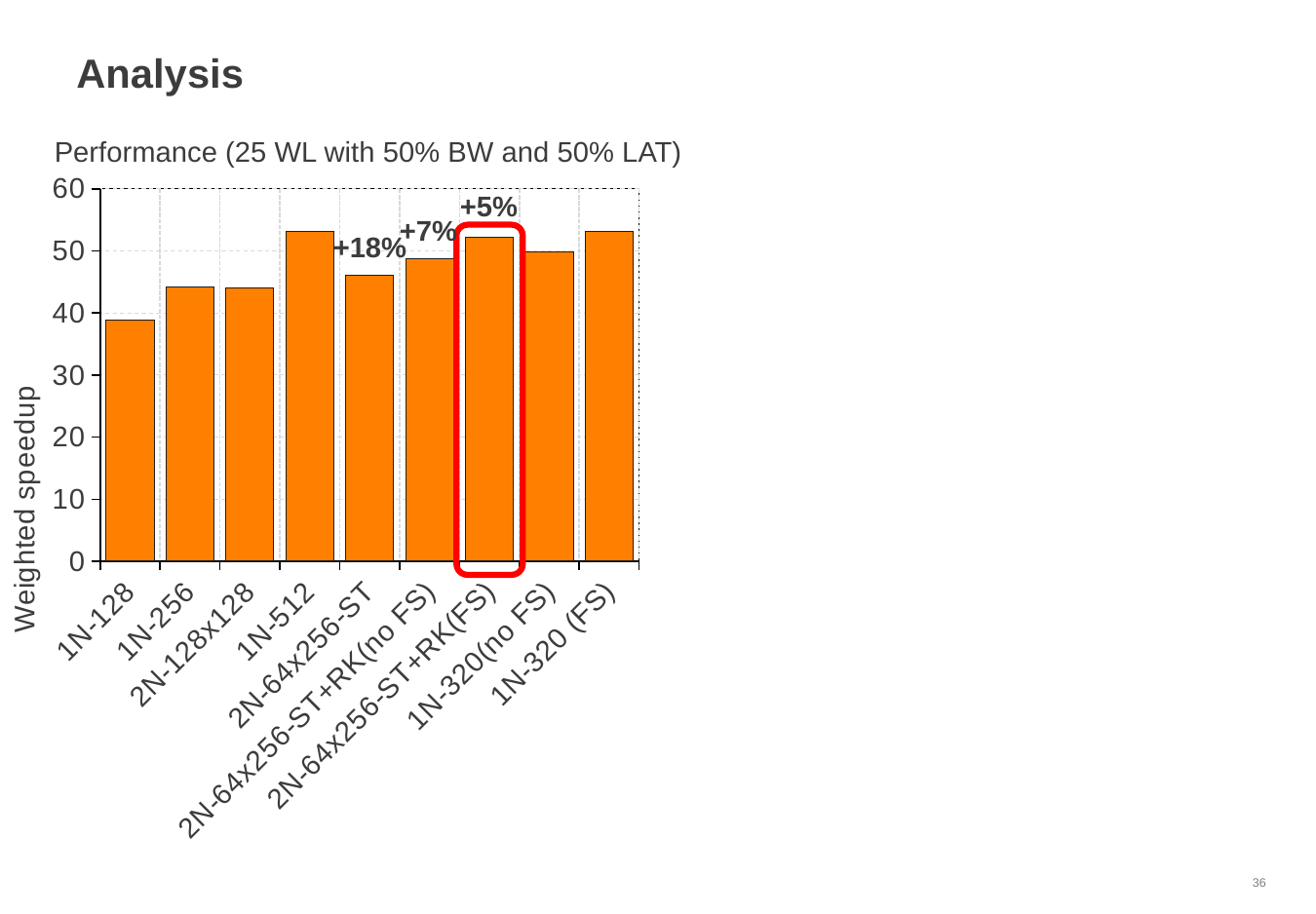
Is the value for 2N-64x256-ST greater or less than 50? less Which has a higher weighted speedup, 2N-64x256-ST+RK(FS) or 2N-64x256-ST? 2N-64x256-ST+RK(FS) What kind of chart is shown on the slide? bar chart Which category has the lowest weighted speedup? 1N-128 Is the value for 1N-256 greater or less than 40? greater Is the value for 2N-64x256-ST+RK(FS) greater or less than 50? greater What is the title of the chart? Performance (25 WL with 50% BW and 50% LAT) What percentage annotation is printed above the bar highlighted with the red box? +5% How many categories are shown on the x axis of the chart? 9 Which has a higher weighted speedup, 1N-512 or 1N-128? 1N-512